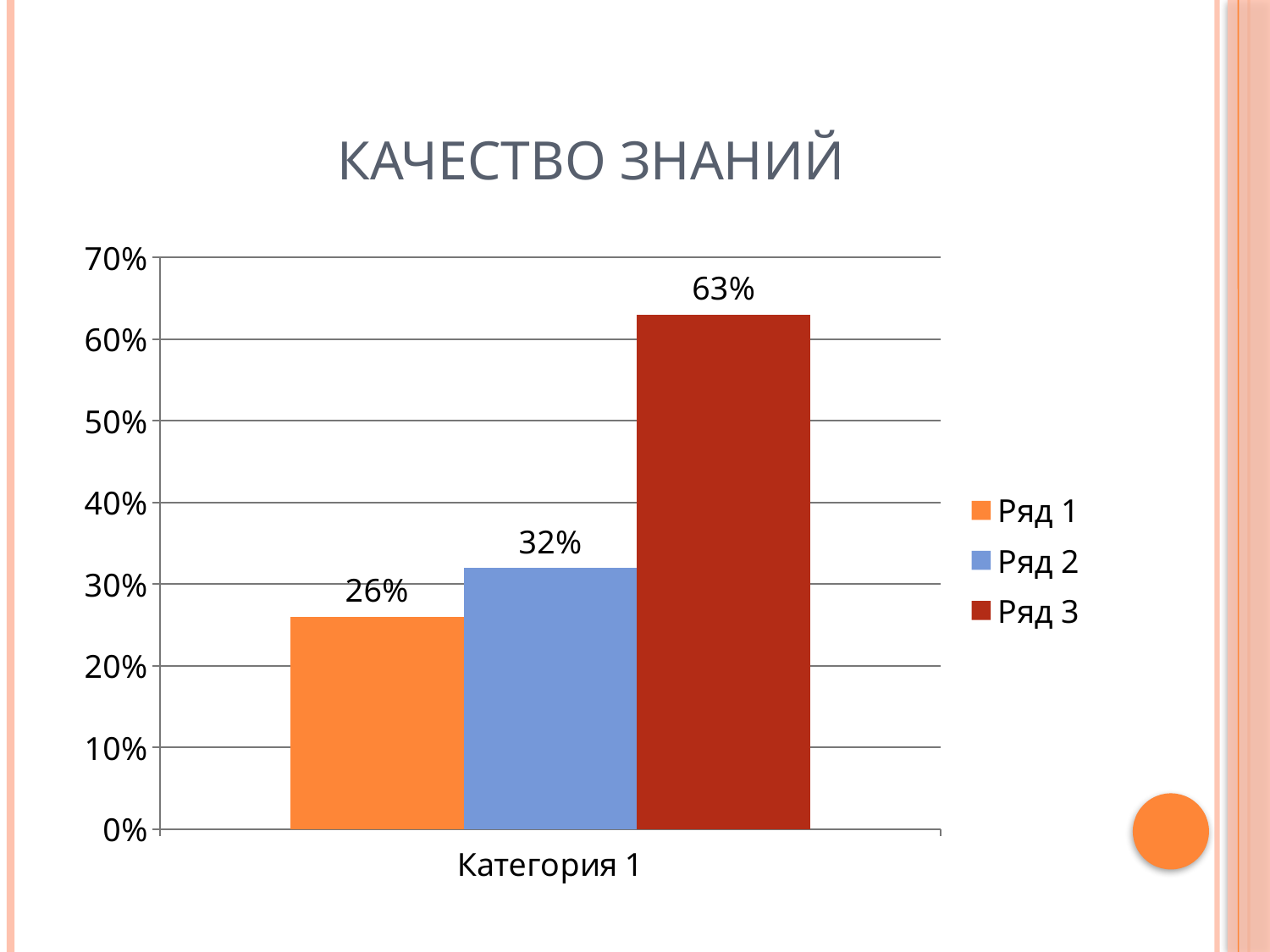
Which series has the highest value? Ряд 3 What is the value for Ряд 1 in Категория 1? 26% How many series does the legend list? 3 Which series has the lowest value? Ряд 1 What is the difference between the values for Ряд 2 and Ряд 1? 6% What is the difference between the values for Ряд 3 and Ряд 1? 37% What is the title of the slide? КАЧЕСТВО ЗНАНИЙ What is the value for Ряд 2 in Категория 1? 32% Is the value for Ряд 3 greater or less than 50%? greater What kind of chart is shown on the slide? bar chart What is the value for Ряд 3 in Категория 1? 63% Which is larger, the value for Ряд 2 or the value for Ряд 3? Ряд 3